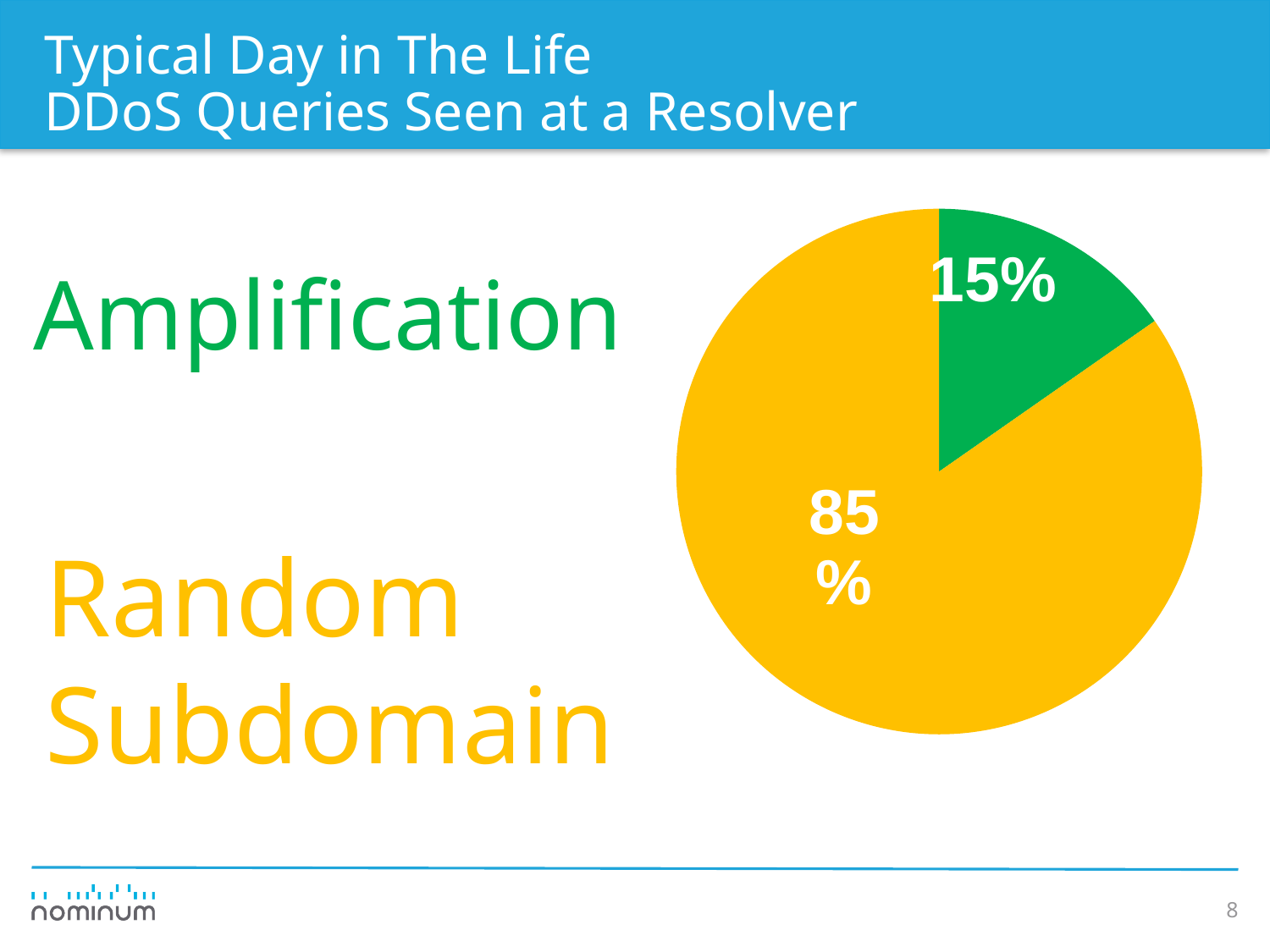
What colour is the Random Subdomain slice? yellow Which is larger, the Amplification slice or the Random Subdomain slice? Random Subdomain What kind of chart is shown on the slide? pie chart What colour is the Amplification slice? green Which category has the largest slice of the pie? Random Subdomain How many slices does the pie chart have? 2 What is the difference in percentage points between the Random Subdomain slice and the Amplification slice? 70 What share of the pie does Random Subdomain represent? 85% What share of the pie does Amplification represent? 15% Which category has the smallest slice of the pie? Amplification